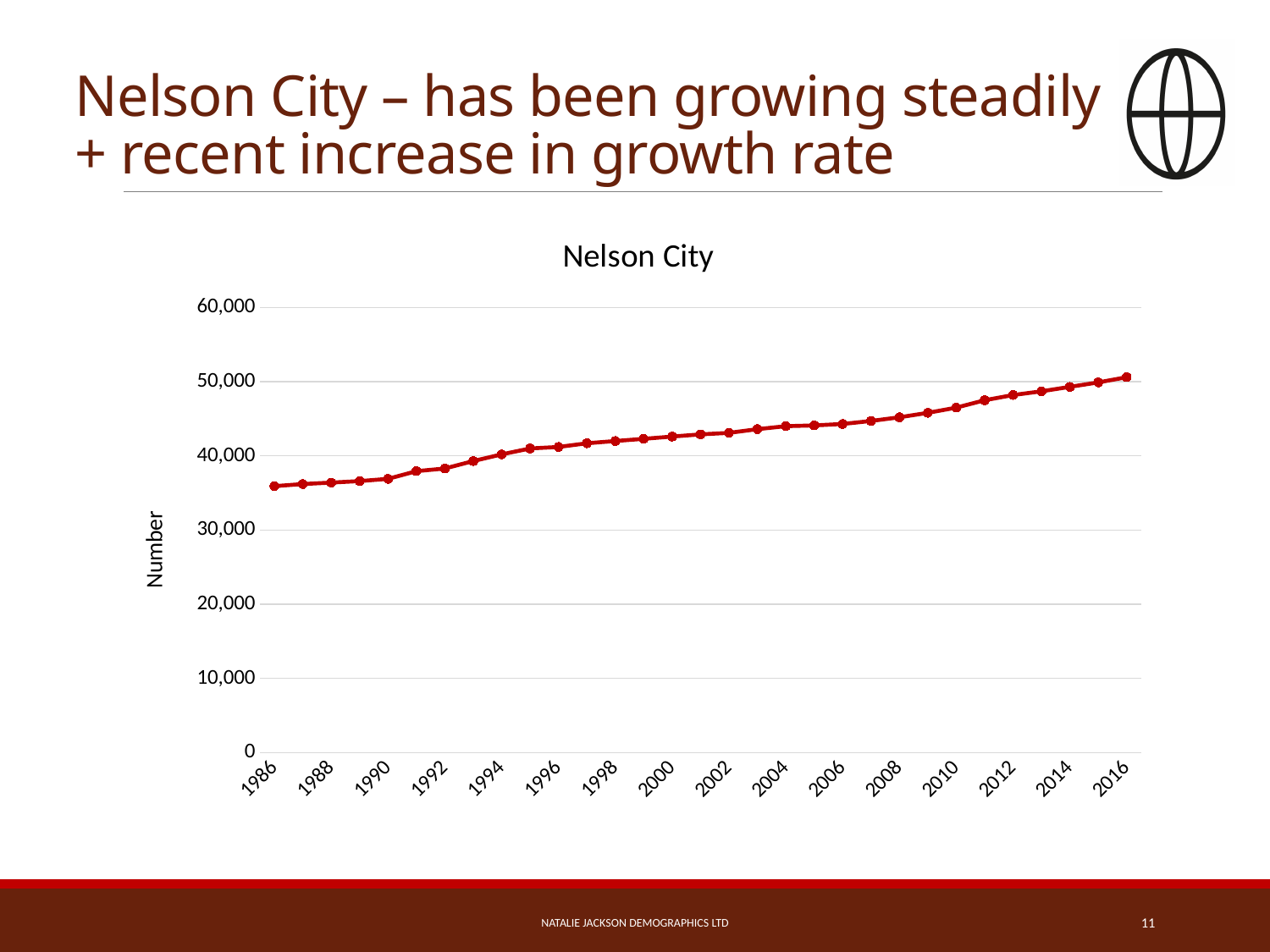
Is the value for 2016 greater or less than 40,000? greater What kind of chart is shown on the slide? line chart Is the value for 1986 greater or less than 40,000? less What is the title of the chart? Nelson City What is the label on the vertical axis of the chart? Number Is the value for 2010 greater or less than 50,000? less How many year labels are shown on the x axis of the chart? 16 Do the values in the chart rise or fall from 1986 to 2016? rise Which year has the lowest value in the chart? 1986 Which is larger, the value for 1986 or the value for 2016? 2016 Which year has the highest value in the chart? 2016